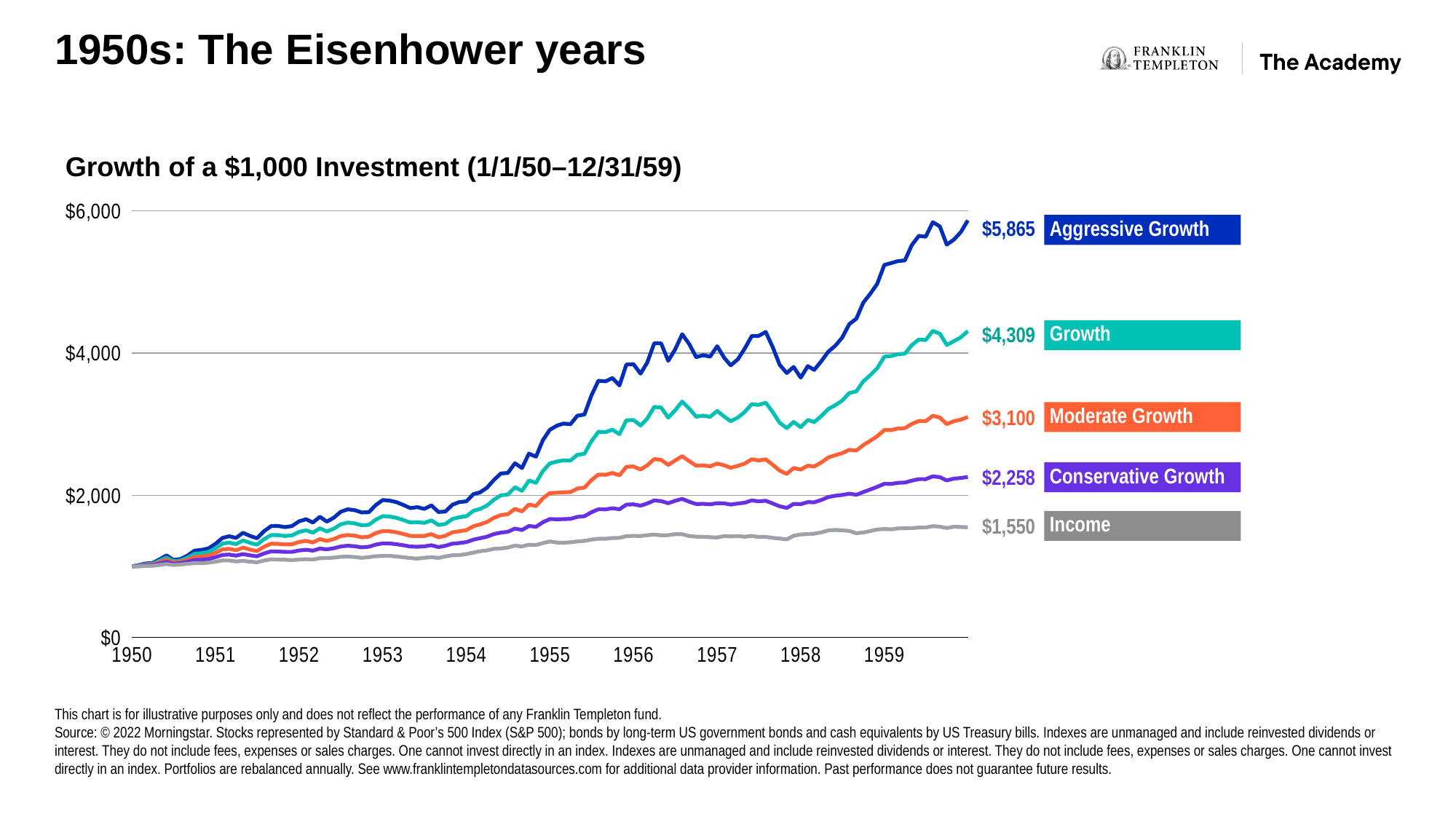
What kind of chart is shown? Line chart Which portfolio has the highest ending value? Aggressive Growth How many portfolios are plotted on the chart? 5 Which has a higher ending value, Moderate Growth or Conservative Growth? Moderate Growth What is the ending value of the Aggressive Growth portfolio? $5,865 What is the title of the chart? Growth of a $1,000 Investment (1/1/50–12/31/59) What is the ending value of the Moderate Growth portfolio? $3,100 Which portfolio has the lowest ending value? Income What is the difference between the ending values of the Growth and Conservative Growth portfolios? $2,051 Is the ending value of the Growth portfolio greater or less than $4,000? greater What is the ending value of the Income portfolio? $1,550 Does the Aggressive Growth line generally rise or fall from 1950 to 1959? Rise